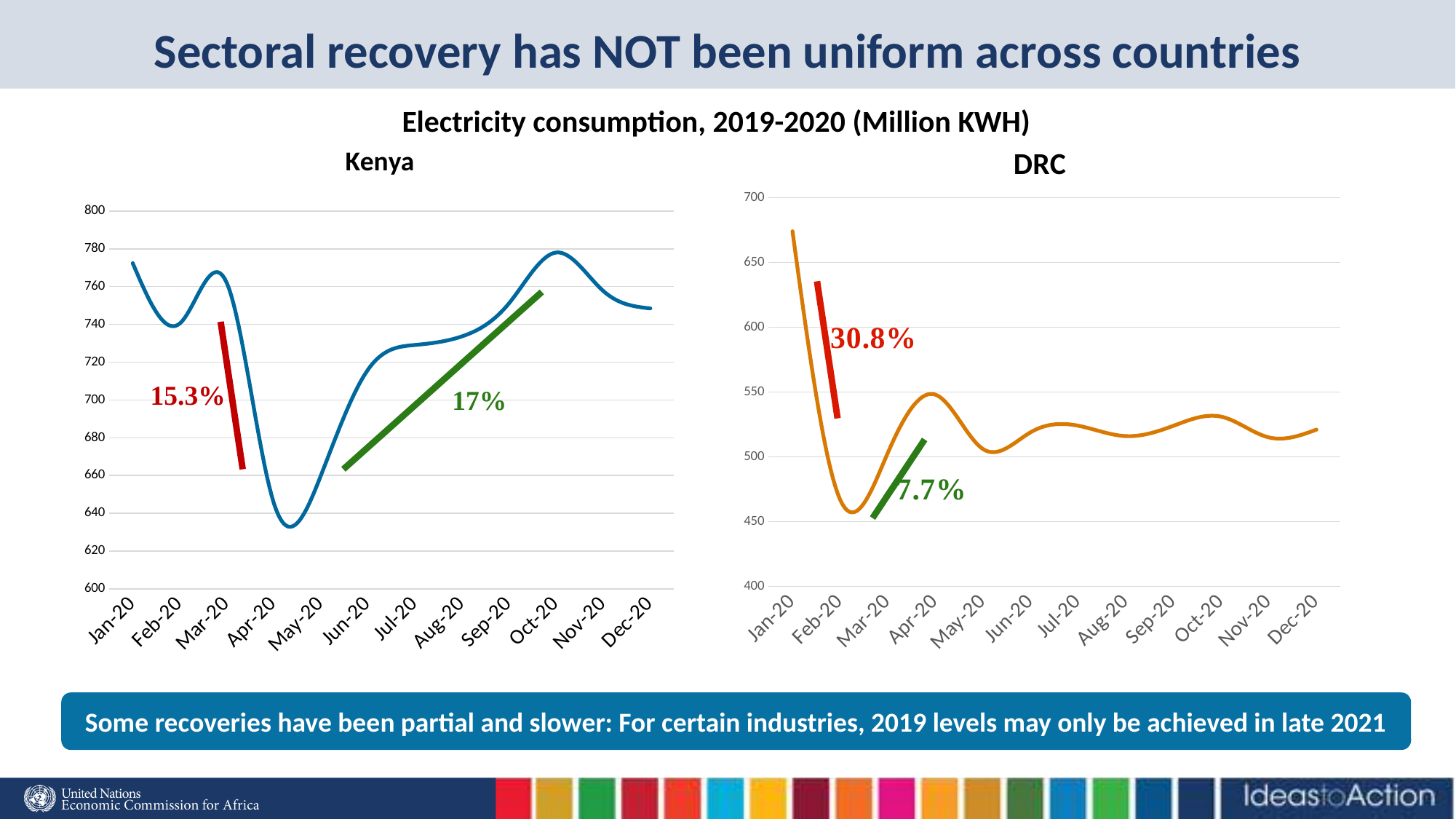
In the Kenya chart, which month has the lowest electricity consumption? Apr-20 In the DRC chart, is the value for Jan-20 greater or less than 650? greater How many months are plotted on the x axis of the DRC chart? 12 In the Kenya chart, is the value for Jan-20 greater or less than 760? greater In the DRC chart, which month has the highest electricity consumption? Jan-20 In the DRC chart, does electricity consumption rise or fall from Jan-20 to Mar-20? fall In the Kenya chart, is the value for Jan-20 larger or smaller than the value for Apr-20? larger What kind of chart is the Kenya chart? line chart In the DRC chart, which month has the lowest electricity consumption? Feb-20 What percentage decline is annotated in red on the DRC chart? 30.8%